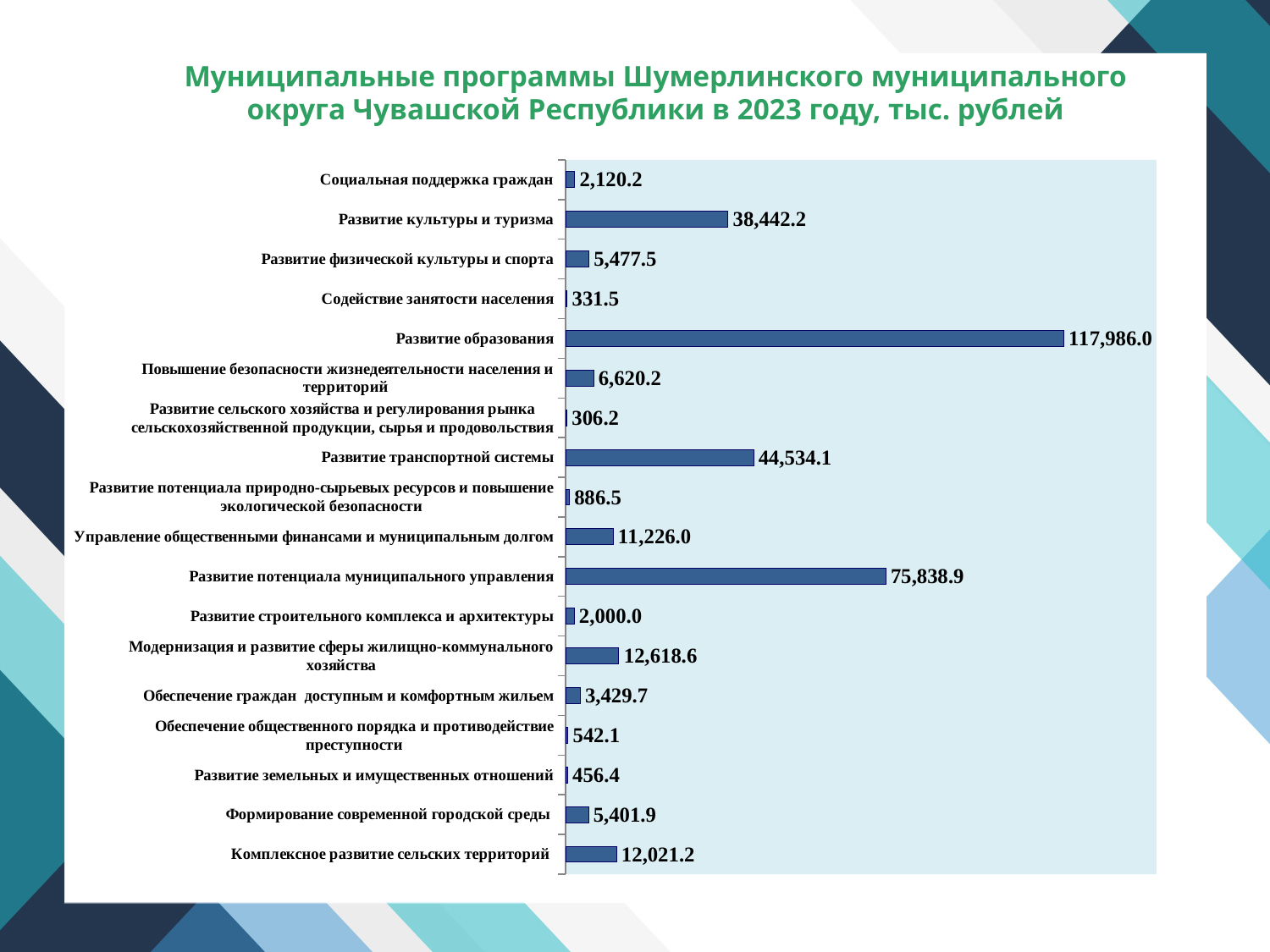
What is the value for Управление общественными финансами и муниципальным долгом? 11,226.0 In what units are the values in the chart expressed, according to the title? тыс. рублей What is the value for Развитие транспортной системы? 44,534.1 What is the value for Формирование современной городской среды? 5,401.9 Which program has the highest value? Развитие образования Which is larger: the value for Модернизация и развитие сферы жилищно-коммунального хозяйства or Комплексное развитие сельских территорий? Модернизация и развитие сферы жилищно-коммунального хозяйства What kind of chart is shown on the slide? Bar chart What is the difference between the values for Развитие транспортной системы and Развитие культуры и туризма? 6,091.9 What is the difference between the values for Развитие образования and Развитие потенциала муниципального управления? 42,147.1 What is the value for Развитие образования? 117,986.0 Which program has the lowest value? Развитие сельского хозяйства и регулирования рынка сельскохозяйственной продукции, сырья и продовольствия How many programs are shown in the chart? 18